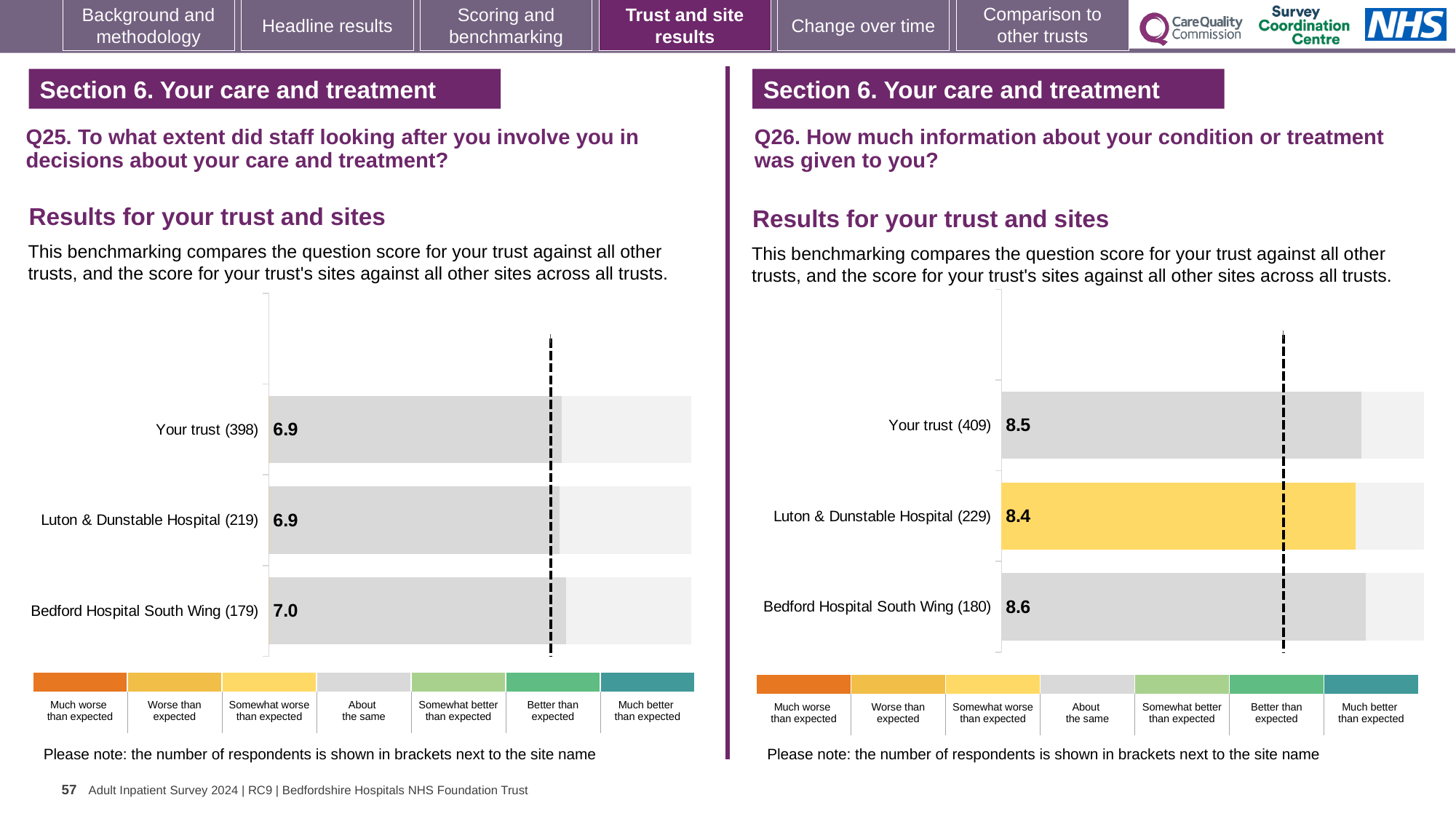
On the Q25 chart (left), what is the score for Your trust (398)? 6.9 What kind of chart is used on the Q26 chart (right)? Bar chart On the Q26 chart (right), what is the score for Your trust (409)? 8.5 On the Q26 chart (right), which benchmark category does the colour of the Luton & Dunstable Hospital (229) bar indicate? Somewhat worse than expected On the Q26 chart (right), what is the score for Luton & Dunstable Hospital (229)? 8.4 On the Q26 chart (right), which site or trust has the lowest score? Luton & Dunstable Hospital (229) On the Q26 chart (right), which has the larger score: Your trust (409) or Luton & Dunstable Hospital (229)? Your trust (409) On the Q25 chart (left), what is the difference between the score for Bedford Hospital South Wing (179) and the score for Luton & Dunstable Hospital (219)? 0.1 On the Q26 chart (right), what is the difference between the score for Bedford Hospital South Wing (180) and the score for Luton & Dunstable Hospital (229)? 0.2 On the Q26 chart (right), which site or trust has the highest score? Bedford Hospital South Wing (180) On the Q25 chart (left), what is the score for Bedford Hospital South Wing (179)? 7.0 How many bars are plotted on the Q25 chart (left)? 3